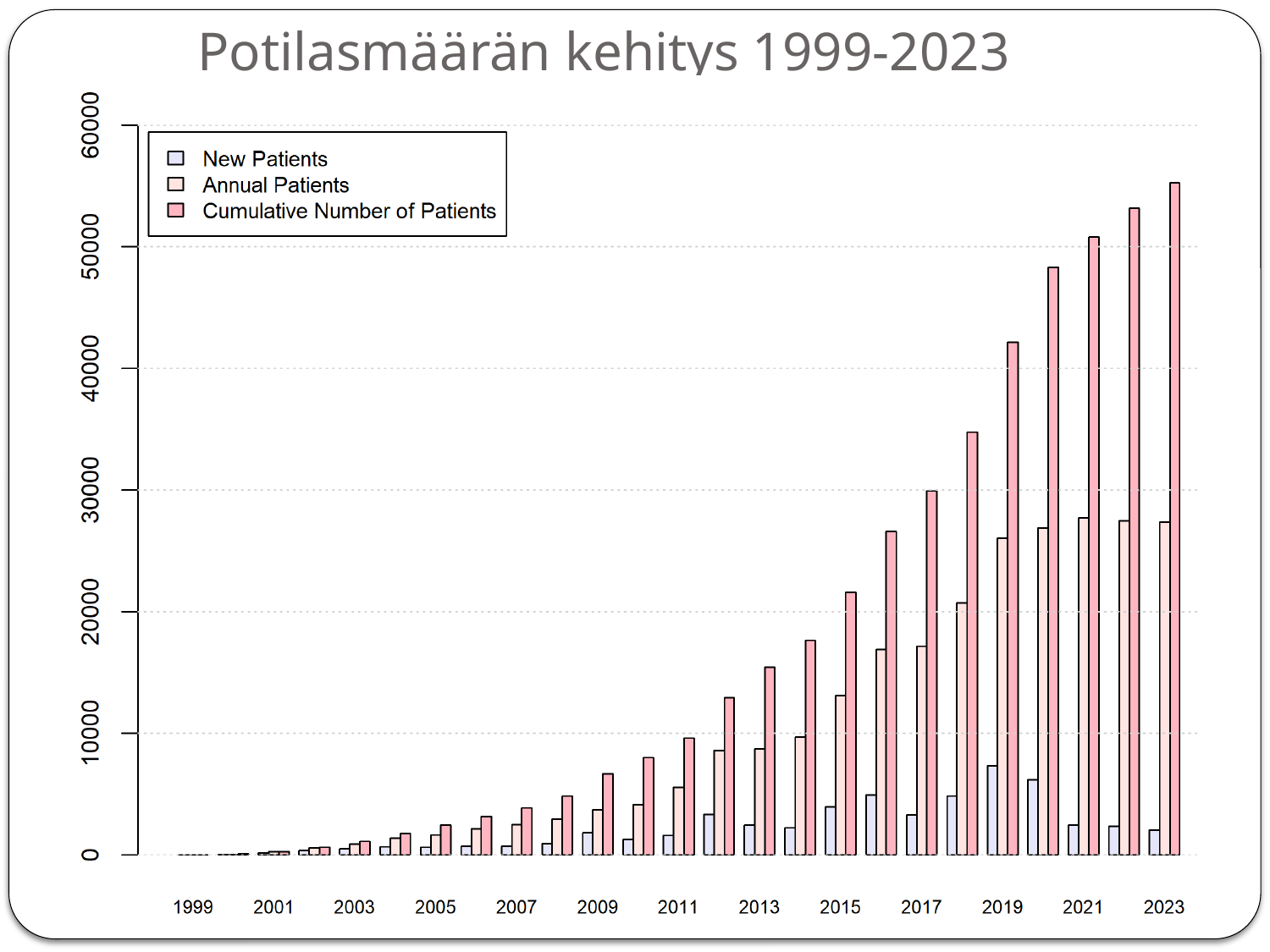
Which series is shown in the darkest pink/red colour in the legend? Cumulative Number of Patients Is the Cumulative Number of Patients for 2018 greater or less than 30000? greater Is the Annual Patients value for 2023 greater or less than 30000? less Is the New Patients value for 2019 greater or less than 10000? less How many series does the legend list? 3 How many years are plotted along the x axis? 25 In which year is the Cumulative Number of Patients highest? 2023 What kind of chart is shown on the slide? bar chart What is the title of the chart? Potilasmäärän kehitys 1999-2023 Does the Cumulative Number of Patients rise or fall from 1999 to 2023? rise